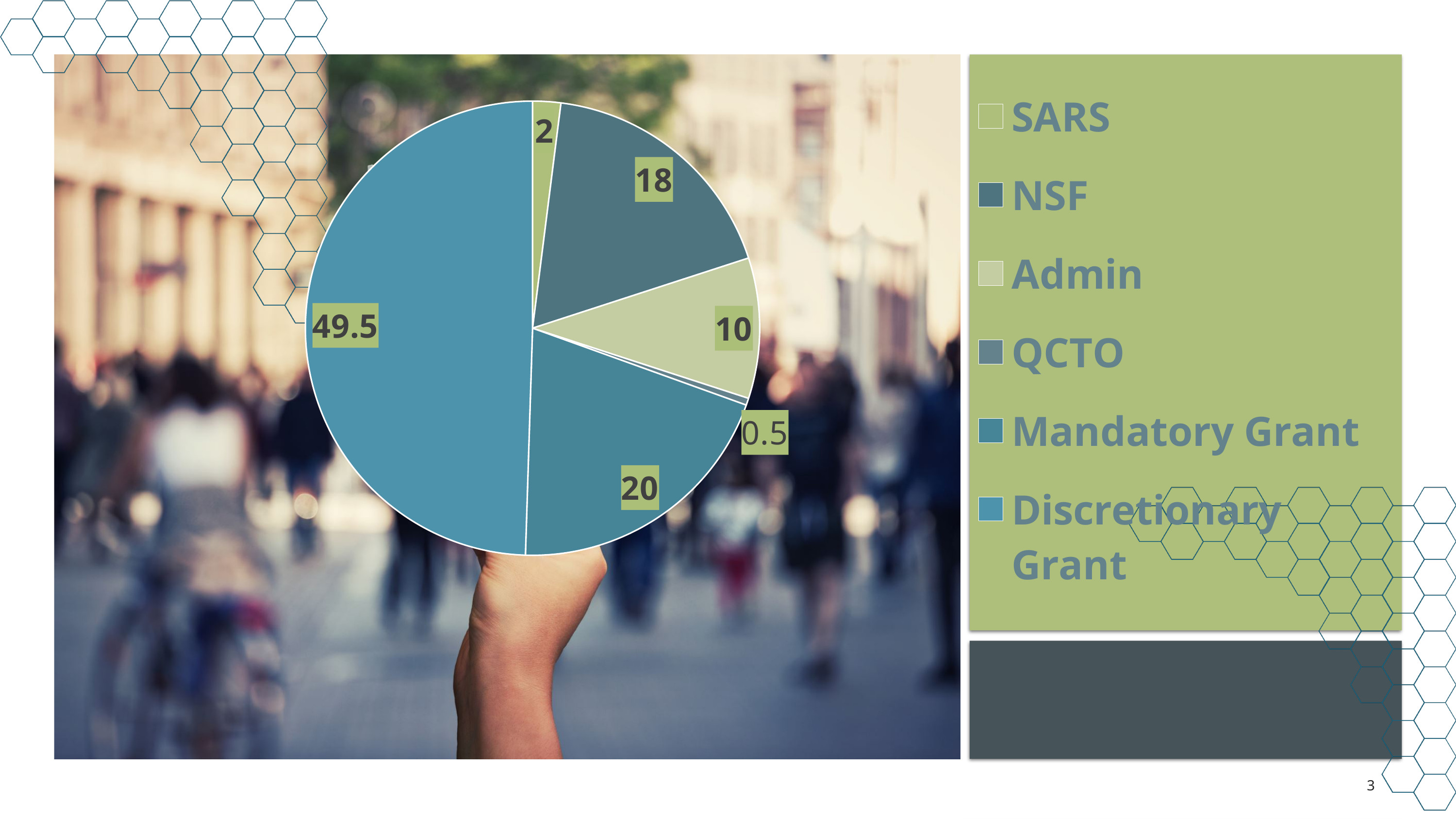
What is the value for SARS? 2 What is the difference between the values for Mandatory Grant and NSF? 2 What is the value for Mandatory Grant? 20 What is the difference between the values for Discretionary Grant and Mandatory Grant? 29.5 How many categories does the legend list? 6 What kind of chart is shown on the slide? pie chart What is the value for NSF? 18 What is the value for QCTO? 0.5 Which is larger, the value for Admin or the value for NSF? NSF What is the value for Discretionary Grant? 49.5 Which category has the smallest slice? QCTO Which category has the largest slice? Discretionary Grant